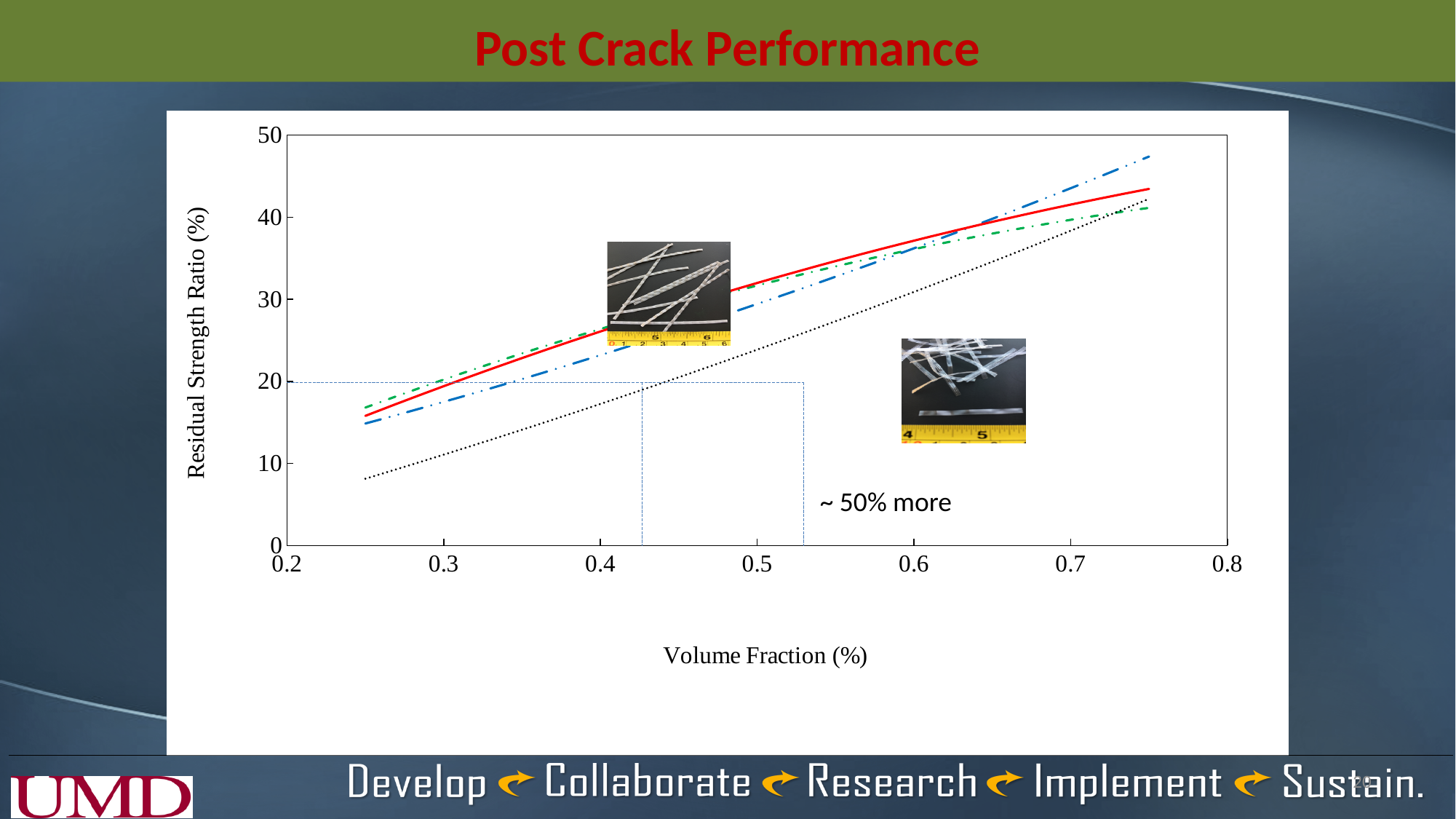
Is the value of the blue dash-dot line at a Volume Fraction of 0.75 greater or less than 40? greater What is the title of the x axis of the chart? Volume Fraction (%) How many lines are plotted on the chart? 4 Which line is the highest at a Volume Fraction of 0.75? the blue dash-dot line At a Volume Fraction of 0.75, which is larger: the red solid line or the black dotted line? the red solid line Do the plotted lines rise or fall as Volume Fraction increases from 0.2 to 0.8? rise What is the maximum value shown on the y axis of the chart? 50 Is the value of the black dotted line at a Volume Fraction of 0.25 greater or less than 10? less What is the title of the y axis of the chart? Residual Strength Ratio (%) Is the value of the black dotted line at a Volume Fraction of 0.3 greater or less than 20? less What kind of chart is shown on the slide? line chart